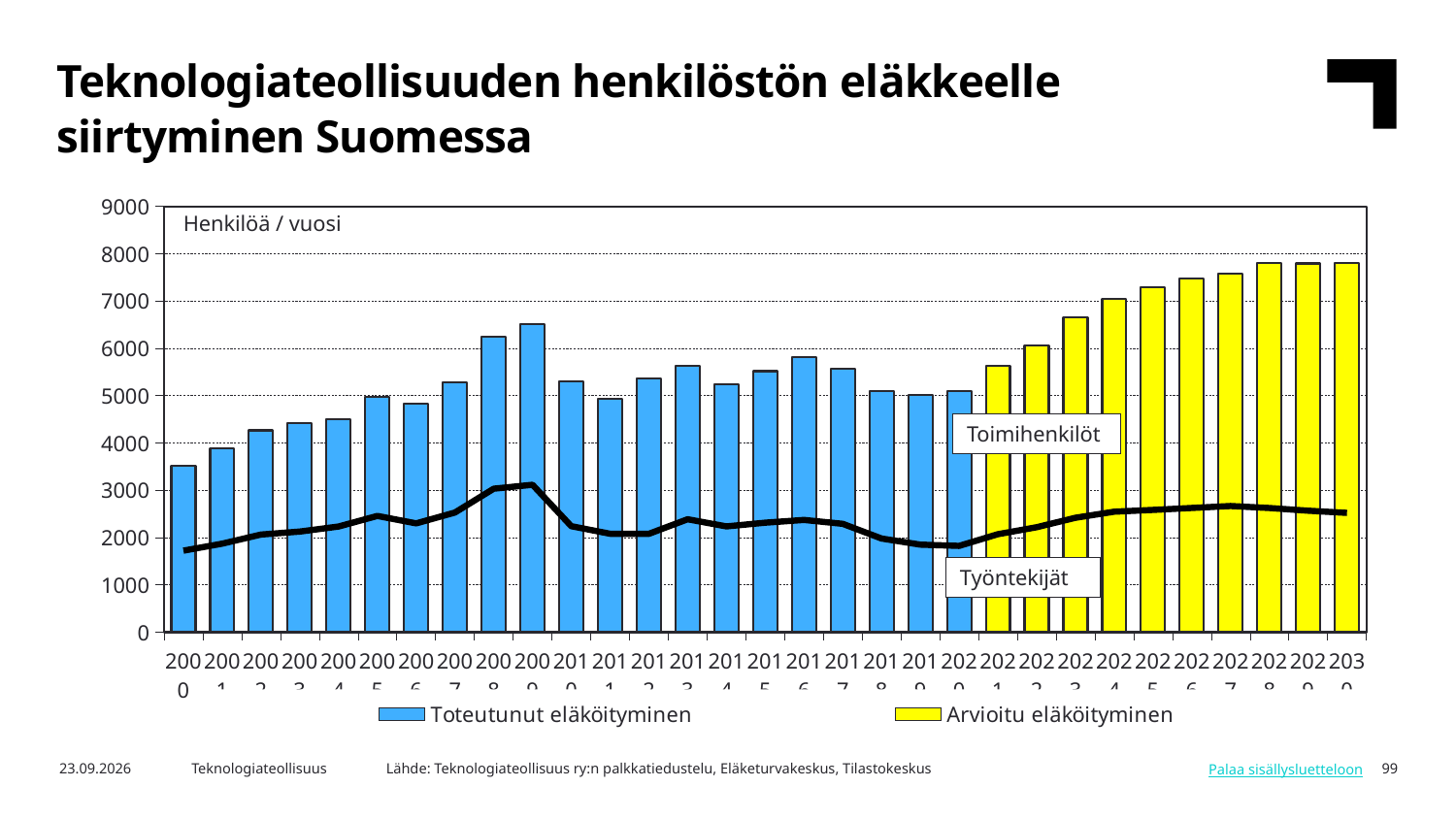
Is the bar for 2030 greater or less than 7000? greater Is the bar for 2009 greater or less than 6000? greater Do the bars rise or fall from 2021 to 2030? rise What colour are the bars for Toteutunut eläköityminen? blue Which year has the lowest bar in the chart? 2000 Is the bar for 2030 greater or less than 8000? less What kind of chart is shown on the slide? combination bar and line chart How many yellow (Arvioitu eläköityminen) bars are there? 10 How many series does the legend list? 2 Which bar is taller, 2009 or 2000? 2009 What unit label is shown at the top left inside the plot area? Henkilöä / vuosi